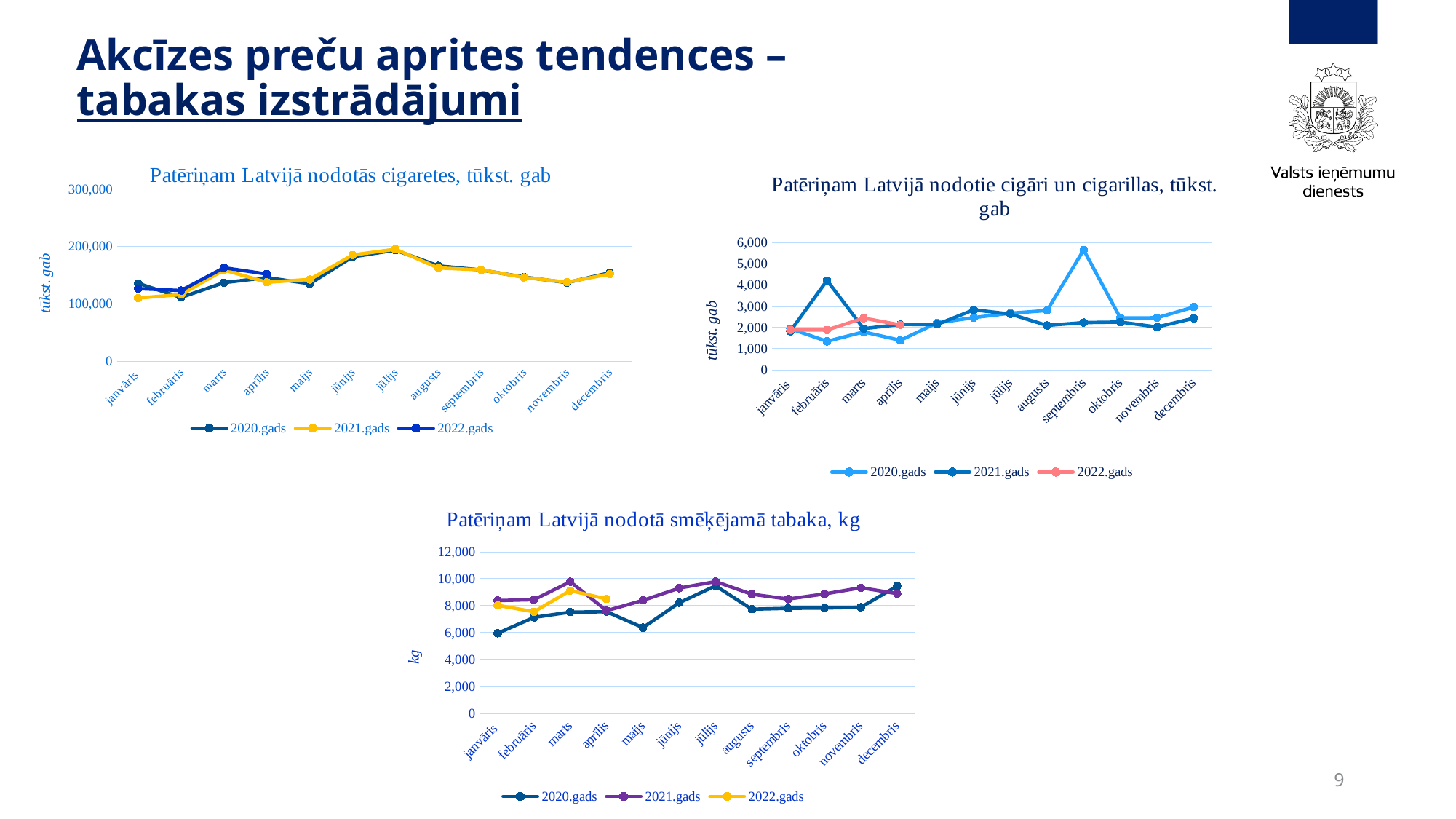
In "Patēriņam Latvijā nodotie cigāri un cigarillas, tūkst. gab", which is larger in februāris: 2020.gads or 2021.gads? 2021.gads What is the y-axis label of "Patēriņam Latvijā nodotā smēķējamā tabaka, kg"? kg In "Patēriņam Latvijā nodotās cigaretes, tūkst. gab", is the value for 2021.gads in jūlijs greater or less than 100,000? greater In "Patēriņam Latvijā nodotie cigāri un cigarillas, tūkst. gab", is the value for 2020.gads in septembris greater or less than 5,000? greater What type of chart is "Patēriņam Latvijā nodotās cigaretes, tūkst. gab"? line chart How many months are shown on the x axis of "Patēriņam Latvijā nodotā smēķējamā tabaka, kg"? 12 In "Patēriņam Latvijā nodotie cigāri un cigarillas, tūkst. gab", which month has the highest value for 2020.gads? septembris In "Patēriņam Latvijā nodotā smēķējamā tabaka, kg", is the value for 2021.gads in marts greater or less than 8,000? greater In "Patēriņam Latvijā nodotā smēķējamā tabaka, kg", which is larger in janvāris: 2020.gads or 2021.gads? 2021.gads In "Patēriņam Latvijā nodotie cigāri un cigarillas, tūkst. gab", which month has the highest value for 2021.gads? februāris How many series does the legend of "Patēriņam Latvijā nodotās cigaretes, tūkst. gab" list? 3